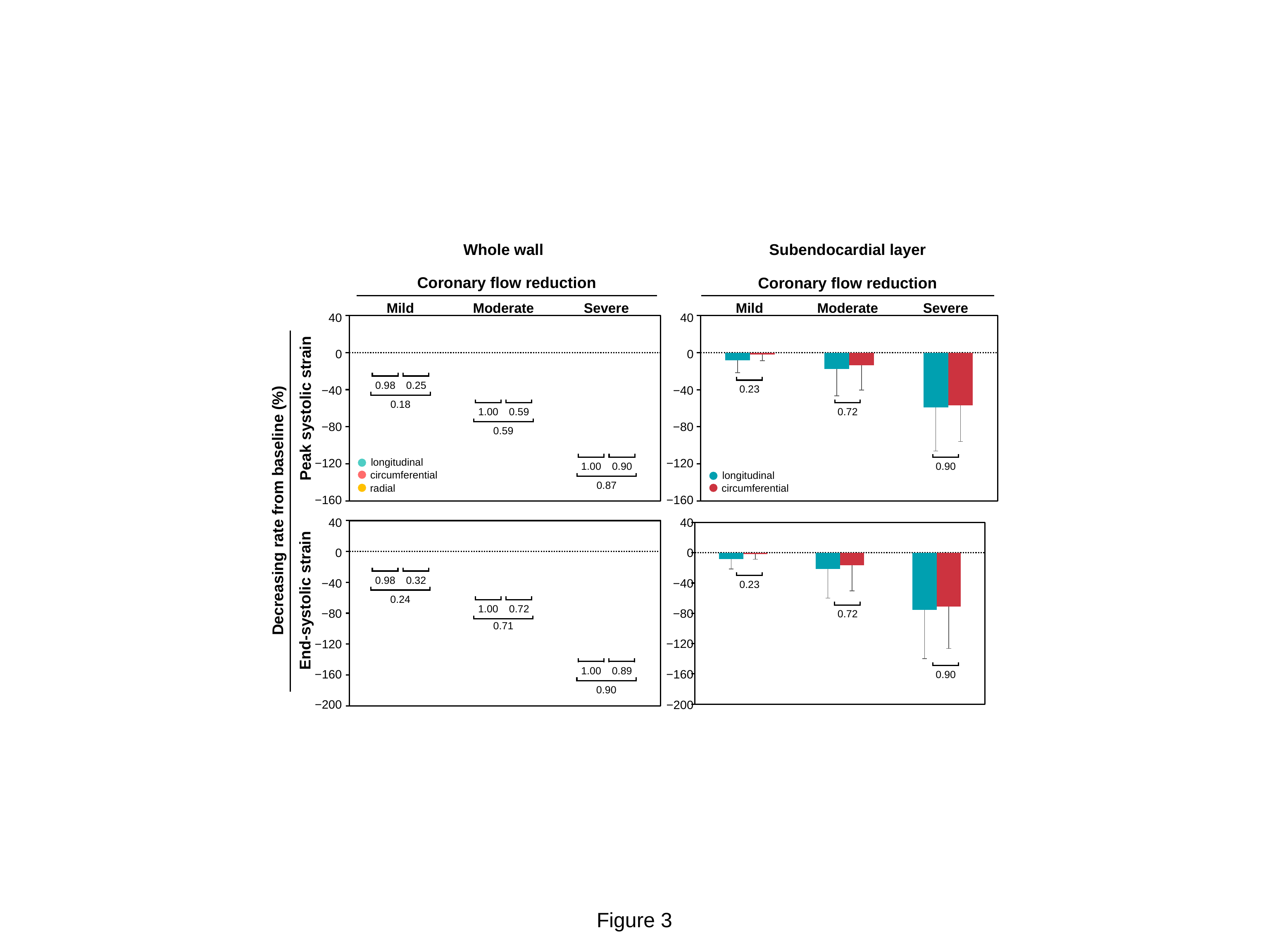
In the Subendocardial layer Peak systolic strain panel, do the longitudinal values rise or fall from Mild to Severe? fall What colour represents the circumferential series in the Subendocardial layer panels? red What kind of chart is the Subendocardial layer Peak systolic strain panel? bar chart In the Subendocardial layer Peak systolic strain panel, is the longitudinal value for Severe greater or less than -40? less In the Subendocardial layer End-systolic strain panel, is the longitudinal value for Severe greater or less than -40? less How many series does the legend of the Whole wall Peak systolic strain panel list? 3 How many coronary flow reduction categories are shown along the x axis of the Subendocardial layer Peak systolic strain panel? 3 How many series does the legend of the Subendocardial layer Peak systolic strain panel list? 2 In the Subendocardial layer End-systolic strain panel, is the circumferential value for Mild greater or less than -40? greater In the Subendocardial layer End-systolic strain panel, which category has the lowest (most negative) longitudinal value? Severe In the Subendocardial layer Peak systolic strain panel, which series has the bar extending further below zero for Mild: longitudinal or circumferential? longitudinal